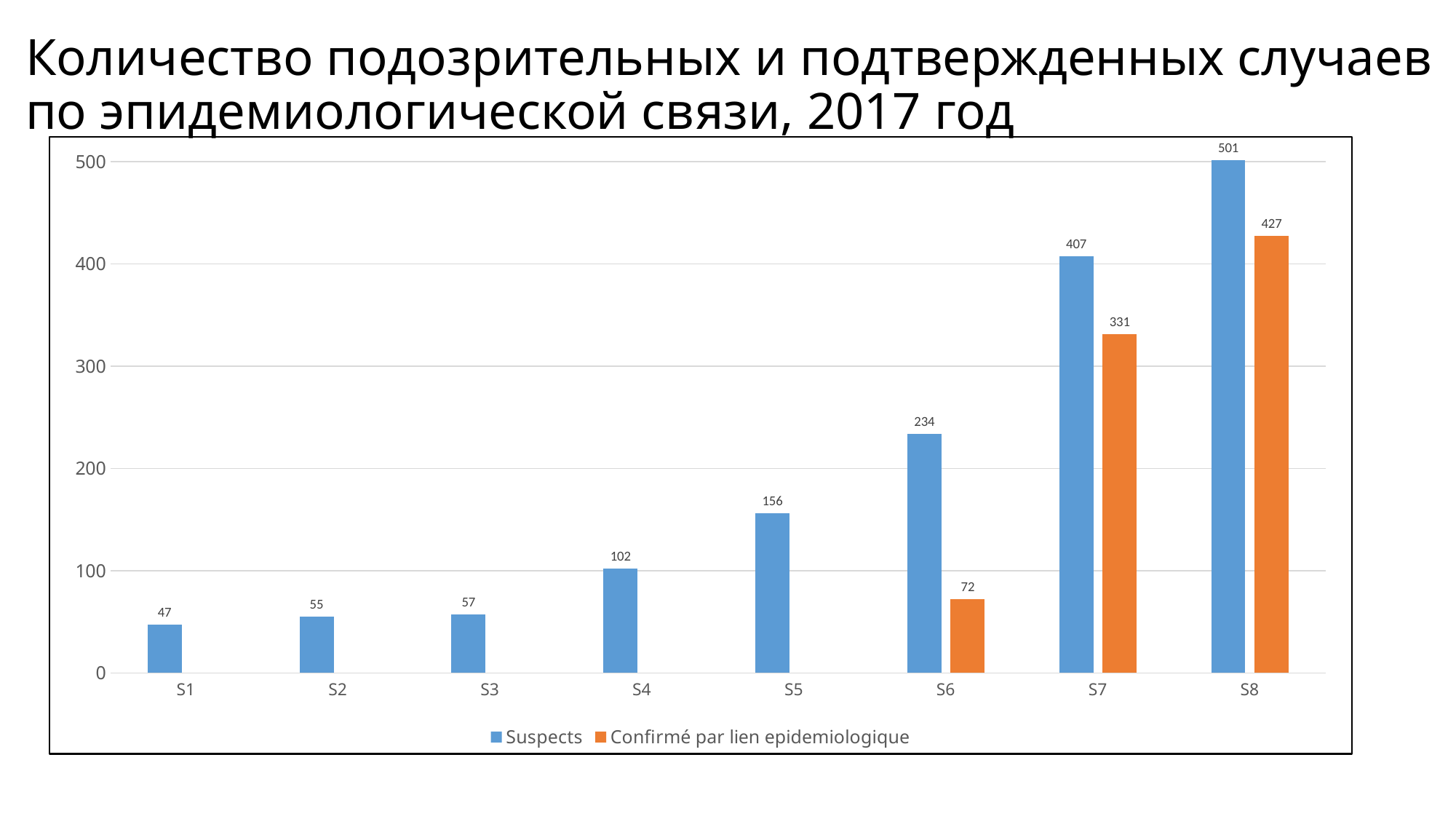
What kind of chart is shown on the slide? Bar chart Which category has the lowest Suspects value? S1 How many categories are shown on the x axis? 8 What is the Suspects value for S5? 156 What is the value of Confirmé par lien epidemiologique for S7? 331 Which category has the highest Suspects value? S8 How many series does the legend list? 2 Which is larger for S6: the Suspects value or the Confirmé par lien epidemiologique value? Suspects What is the Suspects value for S1? 47 Do the Suspects values rise or fall from S1 to S8? Rise What is the difference between the Suspects value and the Confirmé par lien epidemiologique value for S8? 74 Is the Suspects value for S7 greater or less than 400? greater